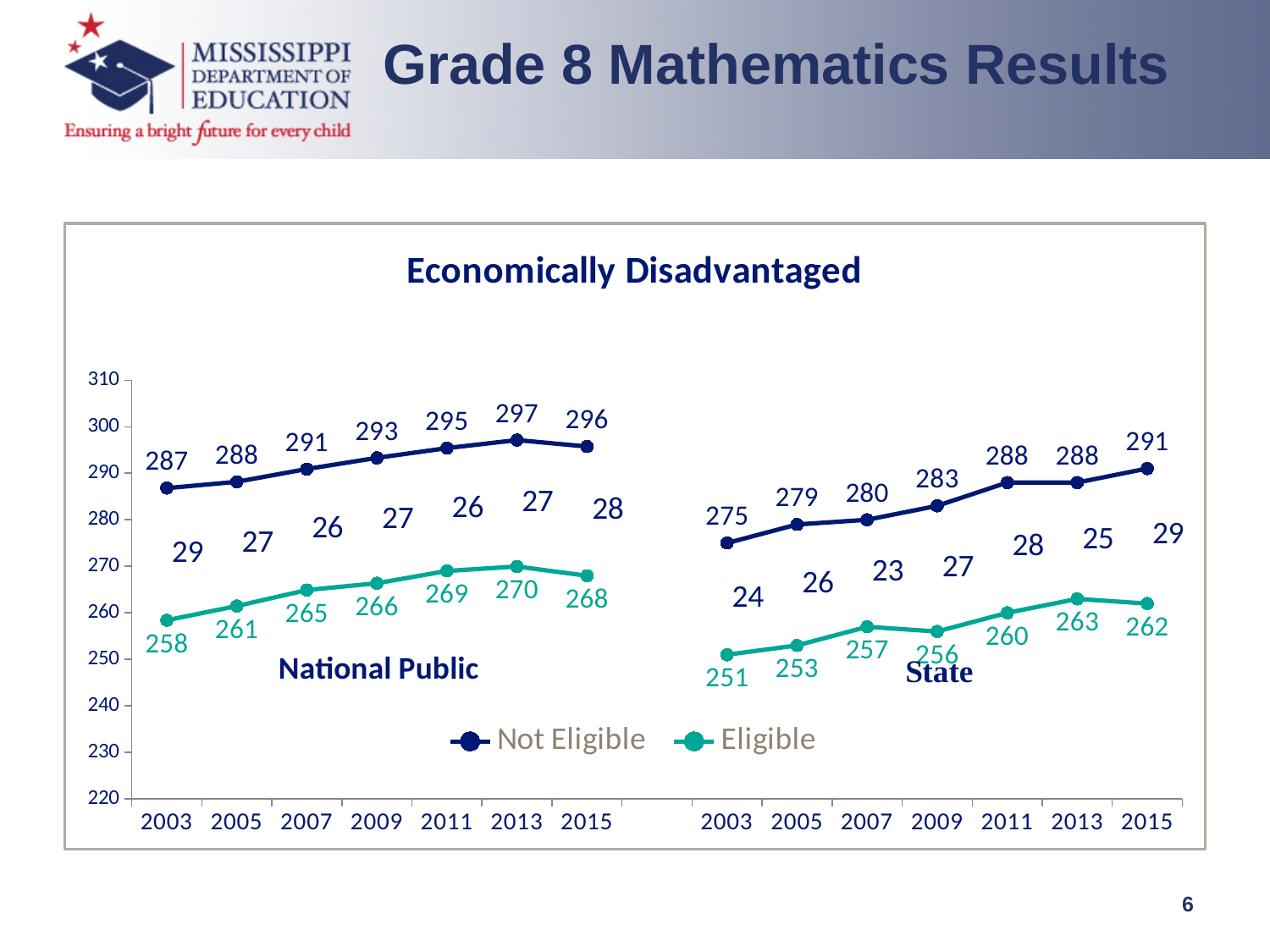
What is the difference between the Not Eligible and Eligible values for State in 2015? 29 In which year is the Eligible value for State lowest? 2003 What is the Not Eligible value for State in 2015? 291 How many series does the legend list? 2 Does the Not Eligible value for State rise or fall from 2003 to 2015? Rise What is the title of the chart? Economically Disadvantaged What kind of chart is shown? Line chart Which is larger, the Eligible value for National Public in 2011 or the Eligible value for State in 2011? National Public in 2011 What is the Eligible value for State in 2003? 251 What is the Not Eligible value for National Public in 2013? 297 What is the Eligible value for National Public in 2015? 268 In which year is the Not Eligible value for National Public highest? 2013